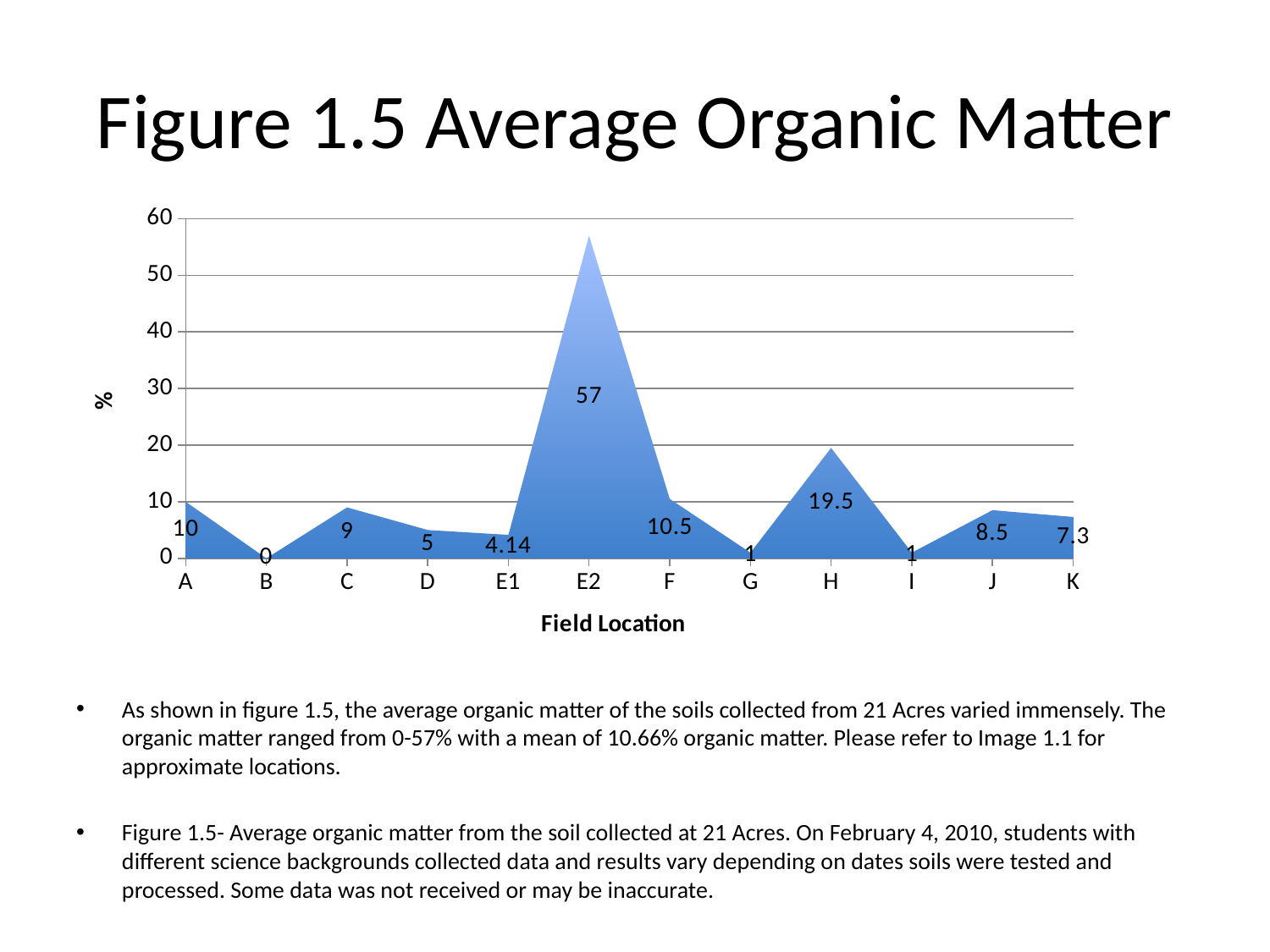
What is the difference between the values for E2 and H? 37.5 How many field locations are shown on the x axis? 12 What is the label of the x axis? Field Location What is the value for field location E1? 4.14 What kind of chart is shown on the slide? Area chart Which field location has the highest average organic matter? E2 Which field location has the lowest average organic matter? B What is the value for field location H? 19.5 What is the average organic matter value for field location E2? 57 What is the difference between the values for A and C? 1 Is the value for field location E2 greater or less than 50? greater Which has a larger value, field location F or field location J? F